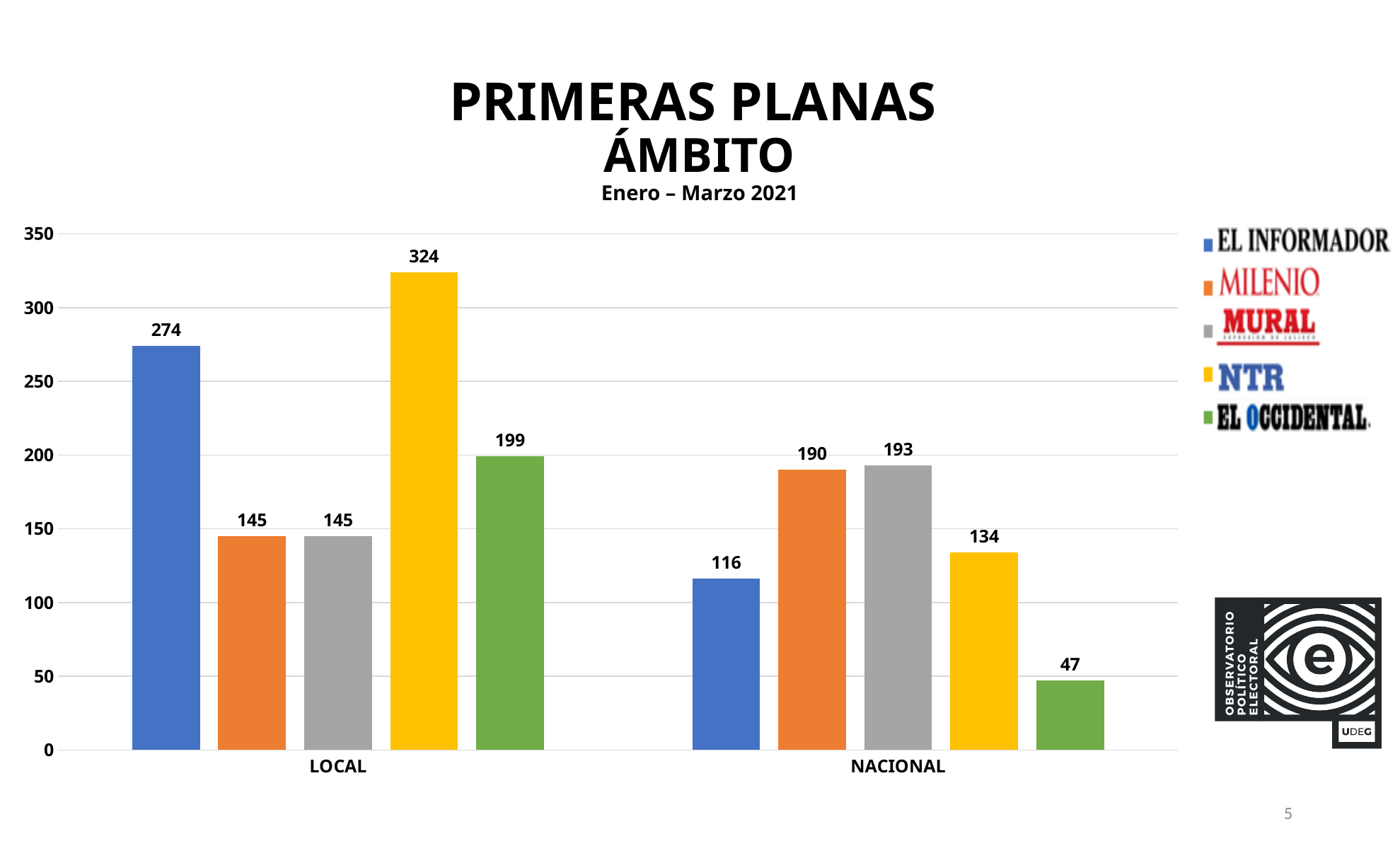
Which newspaper has the highest value in the LOCAL category? NTR How many categories are shown on the x axis? 2 What is the difference between the NTR and EL OCCIDENTAL values in the LOCAL category? 125 What is the value for NTR in the LOCAL category? 324 What is the value for EL OCCIDENTAL in the NACIONAL category? 47 Which is larger: MILENIO in LOCAL or MILENIO in NACIONAL? MILENIO in NACIONAL Which newspaper has the lowest value in the NACIONAL category? EL OCCIDENTAL What kind of chart is shown on the slide? Bar chart What period does the chart subtitle indicate? Enero – Marzo 2021 What is the difference between the LOCAL and NACIONAL values for EL INFORMADOR? 158 What is the value for EL INFORMADOR in the NACIONAL category? 116 How many series does the legend list? 5